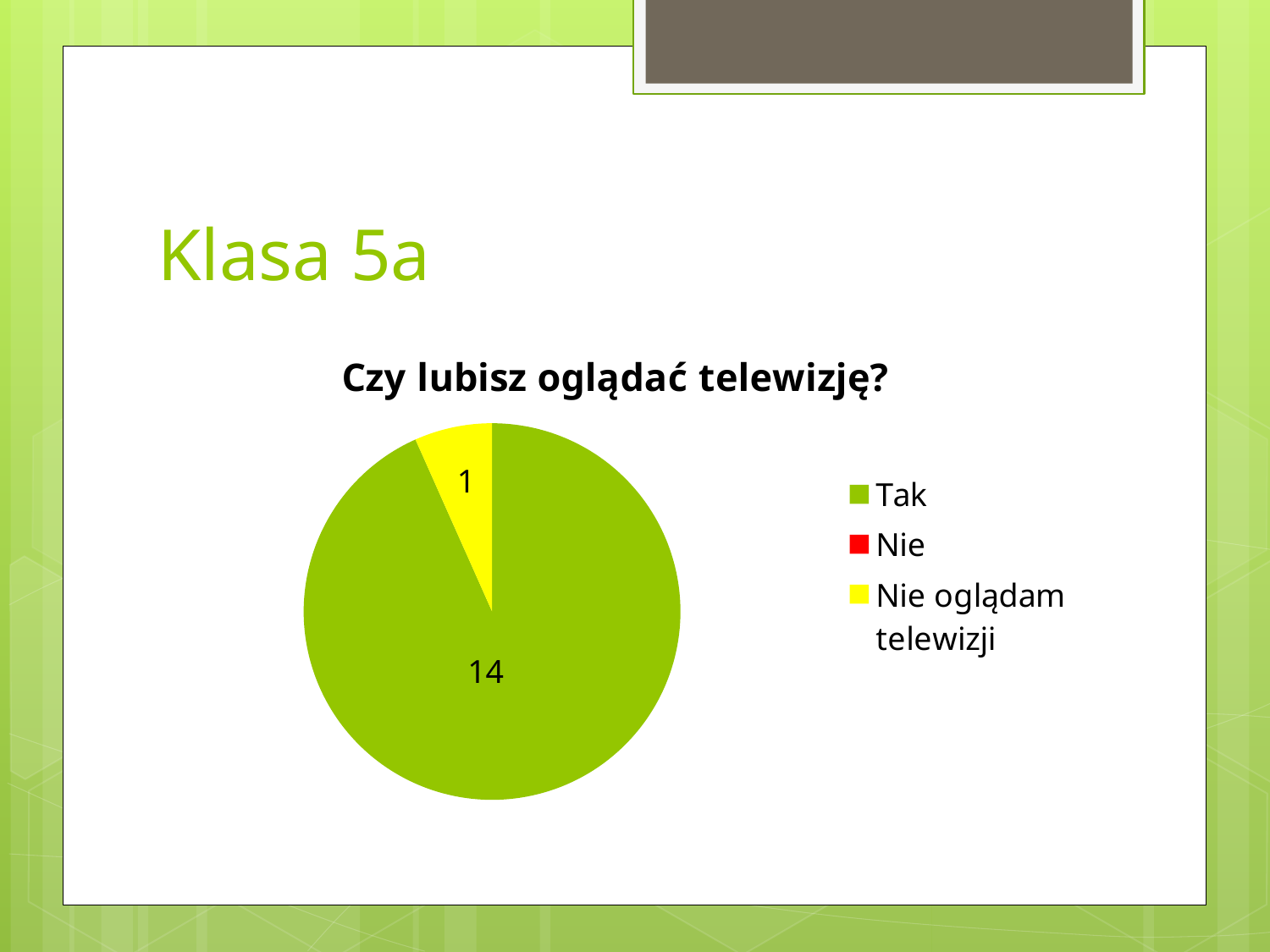
What is the difference between the "Tak" value and the "Nie oglądam telewizji" value? 13 What is the value of the "Nie oglądam telewizji" slice in the pie chart? 1 Which category has the largest slice in the pie chart? Tak What is the value of the "Tak" slice in the pie chart? 14 Which is larger, the "Tak" slice or the "Nie oglądam telewizji" slice? Tak What kind of chart is shown on the slide? Pie chart What colour represents "Nie oglądam telewizji" in the legend? Yellow What is the title of the chart? Czy lubisz oglądać telewizję? How many entries does the chart legend list? 3 How many slices with data labels are visible in the pie chart? 2